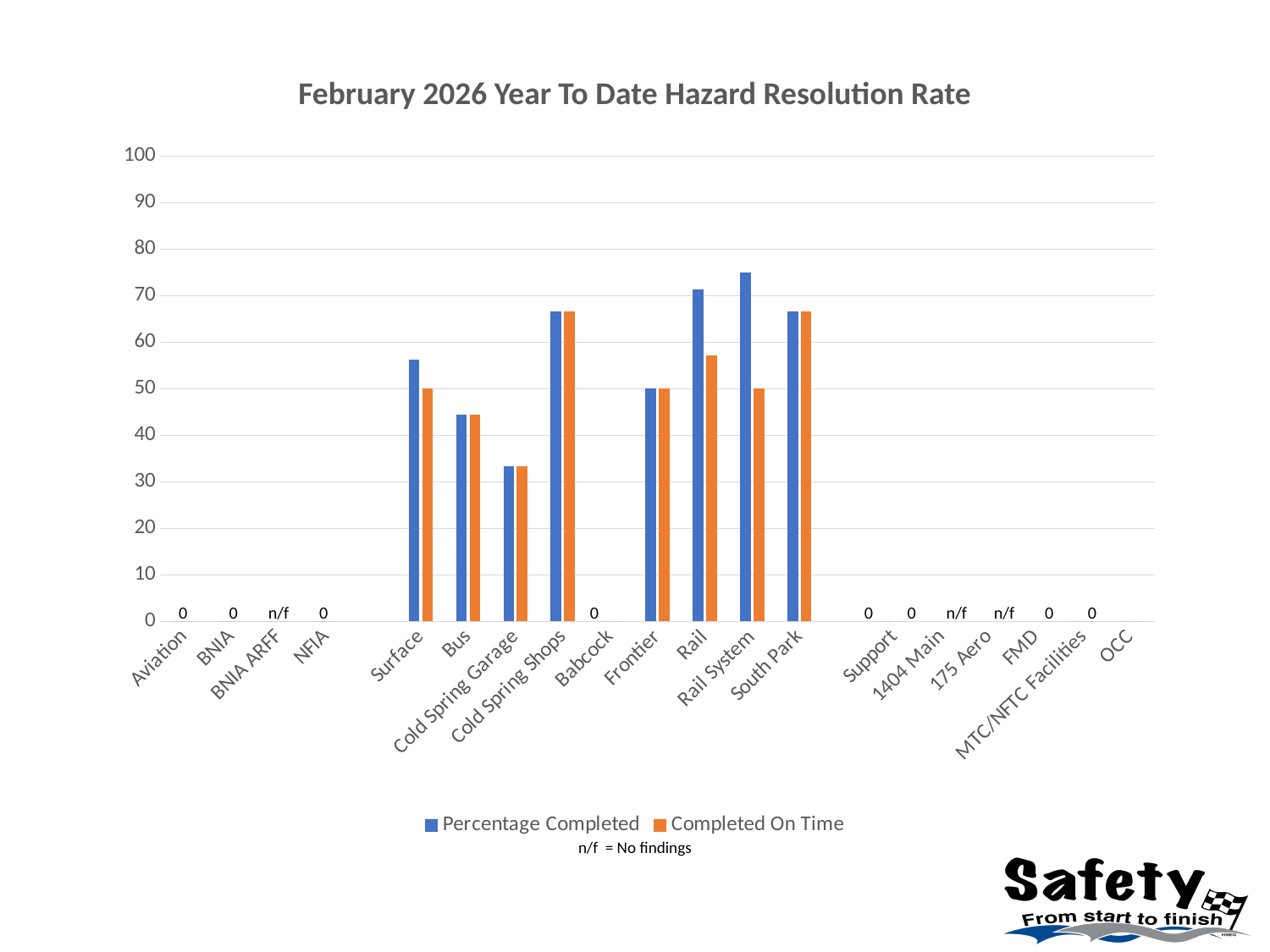
What kind of chart is shown on the slide? Bar chart What label is shown for BNIA ARFF? n/f For Rail System, which is larger: Percentage Completed or Completed On Time? Percentage Completed Is the Percentage Completed value for Rail System greater or less than 70? greater Is the Percentage Completed value for Cold Spring Garage greater or less than 40? less What value is labelled for Aviation? 0 How many categories are labelled n/f on the chart? 3 According to the note under the legend, what does n/f stand for? No findings What is the title of the chart? February 2026 Year To Date Hazard Resolution Rate Which category has the highest Percentage Completed bar? Rail System Is the Completed On Time value for Rail greater or less than 50? greater How many series does the legend list? 2